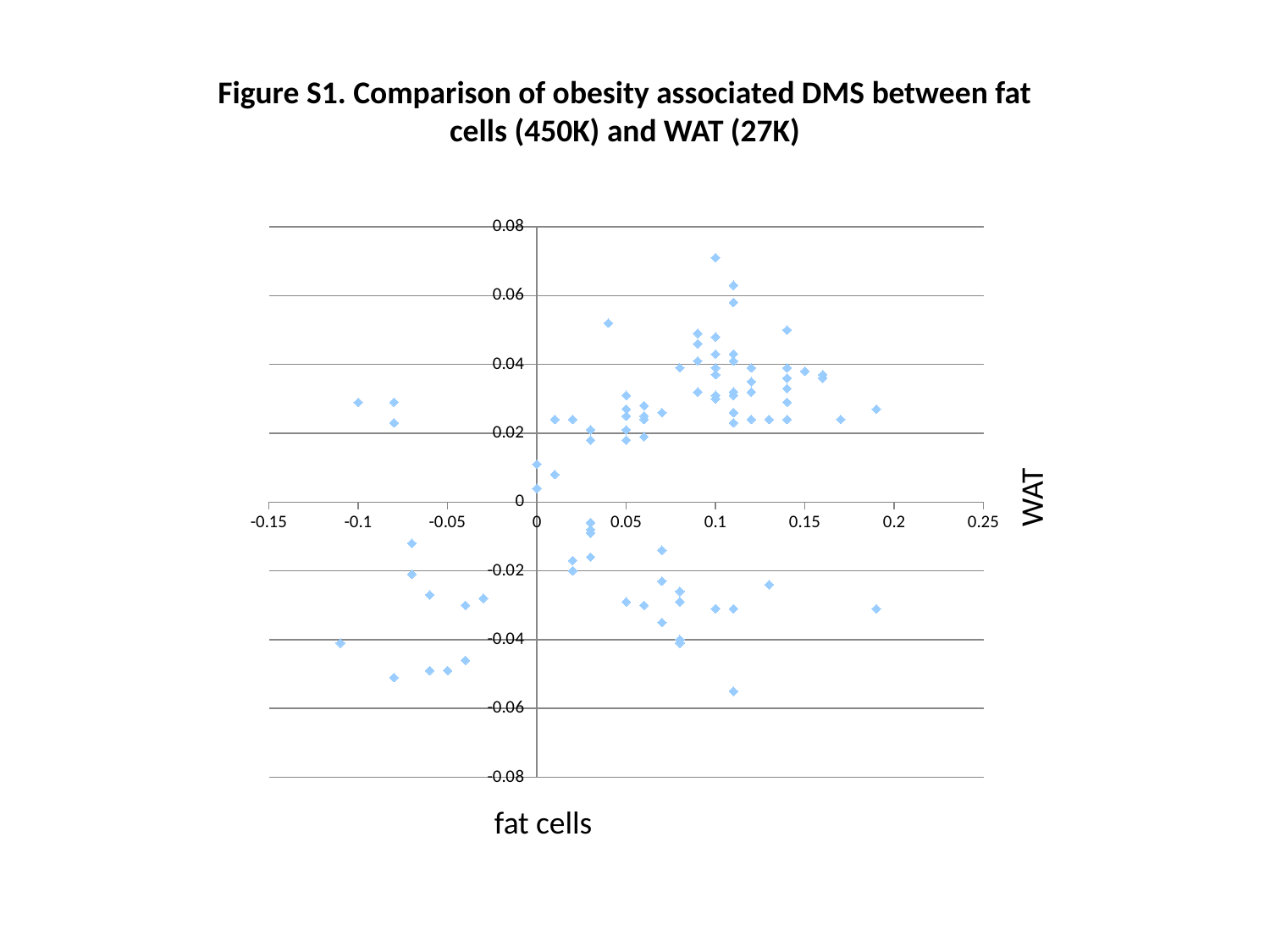
What is the label of the horizontal axis of the chart? fat cells What is the maximum value shown on the vertical (WAT) axis? 0.08 Is the WAT value of the lowest point on the chart greater or less than -0.04? less What is the minimum value shown on the horizontal (fat cells) axis? -0.15 What is the title of the chart on the slide? Figure S1. Comparison of obesity associated DMS between fat cells (450K) and WAT (27K) Is the fat cells value of the leftmost point on the chart greater or less than -0.1? less Is the WAT value of the highest point on the chart greater or less than 0.06? greater What is the maximum value shown on the horizontal (fat cells) axis? 0.25 What kind of chart is shown on the slide? scatter chart